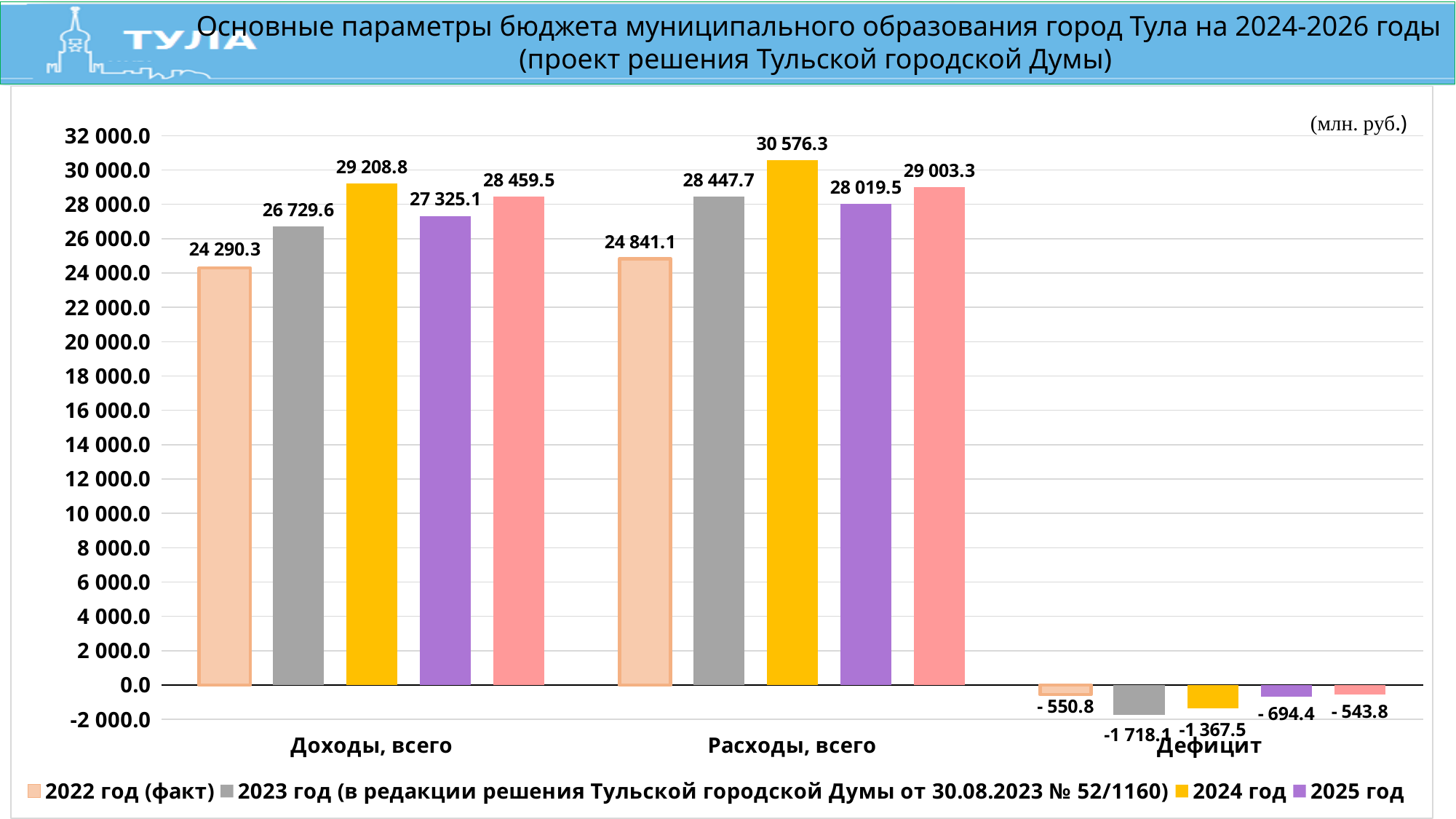
Which year has the lowest value in the Доходы, всего category? 2022 год (факт) Which is larger: the 2025 год value for Доходы, всего or the 2025 год value for Расходы, всего? Расходы, всего What is the value for 2023 год in the Доходы, всего category? 26 729.6 What unit is indicated in the top right corner of the chart? млн. руб. Is the 2023 год value for Расходы, всего greater or less than 28 000.0? greater What is the value for 2024 год in the Доходы, всего category? 29 208.8 What is the value for 2025 год in the Дефицит category? - 694.4 What is the difference between the 2024 год and 2022 год (факт) values in the Доходы, всего category? 4 918.5 How many categories are shown on the x axis? 3 What type of chart is shown on the slide? bar chart What is the value for 2022 год (факт) in the Расходы, всего category? 24 841.1 Which year has the highest value in the Расходы, всего category? 2024 год